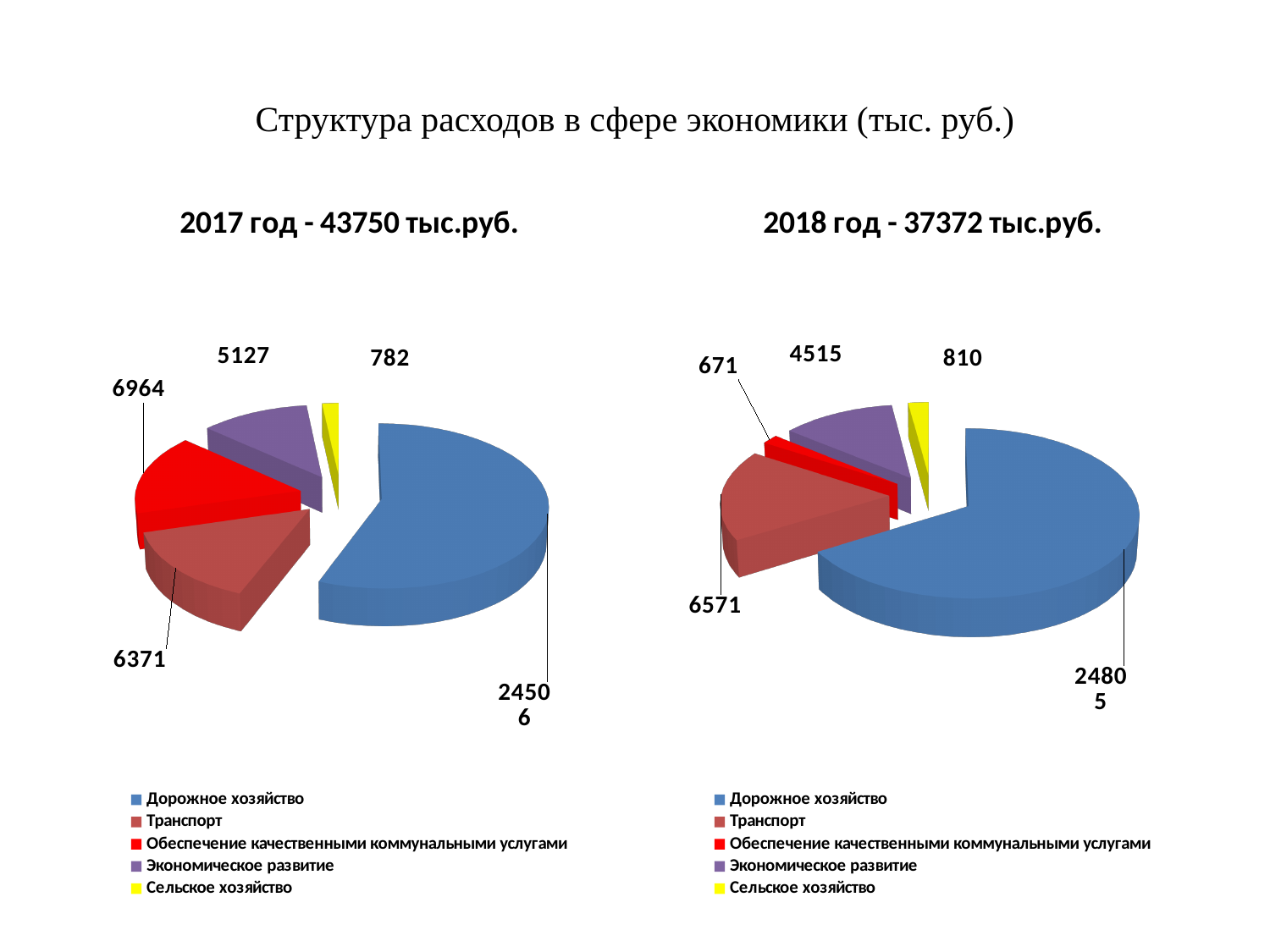
In the 2017 год chart, which colour represents Сельское хозяйство? yellow What kind of chart is used for the 2017 год chart? pie chart In the 2018 год chart, what is the value for Транспорт? 6571 In the 2017 год chart, what is the difference between Обеспечение качественными коммунальными услугами and Транспорт? 593 In the 2017 год chart, what is the value for Дорожное хозяйство? 24506 What is the total of all slices in the 2018 год chart? 37372 In the 2018 год chart, which category has the smallest value? Обеспечение качественными коммунальными услугами In the 2018 год chart, what is the value for Сельское хозяйство? 810 In the 2018 год chart, which is larger: Экономическое развитие or Транспорт? Транспорт In the 2017 год chart, which category has the largest value? Дорожное хозяйство In the 2017 год chart, what is the value for Обеспечение качественными коммунальными услугами? 6964 How many categories does the legend of the 2018 год chart list? 5